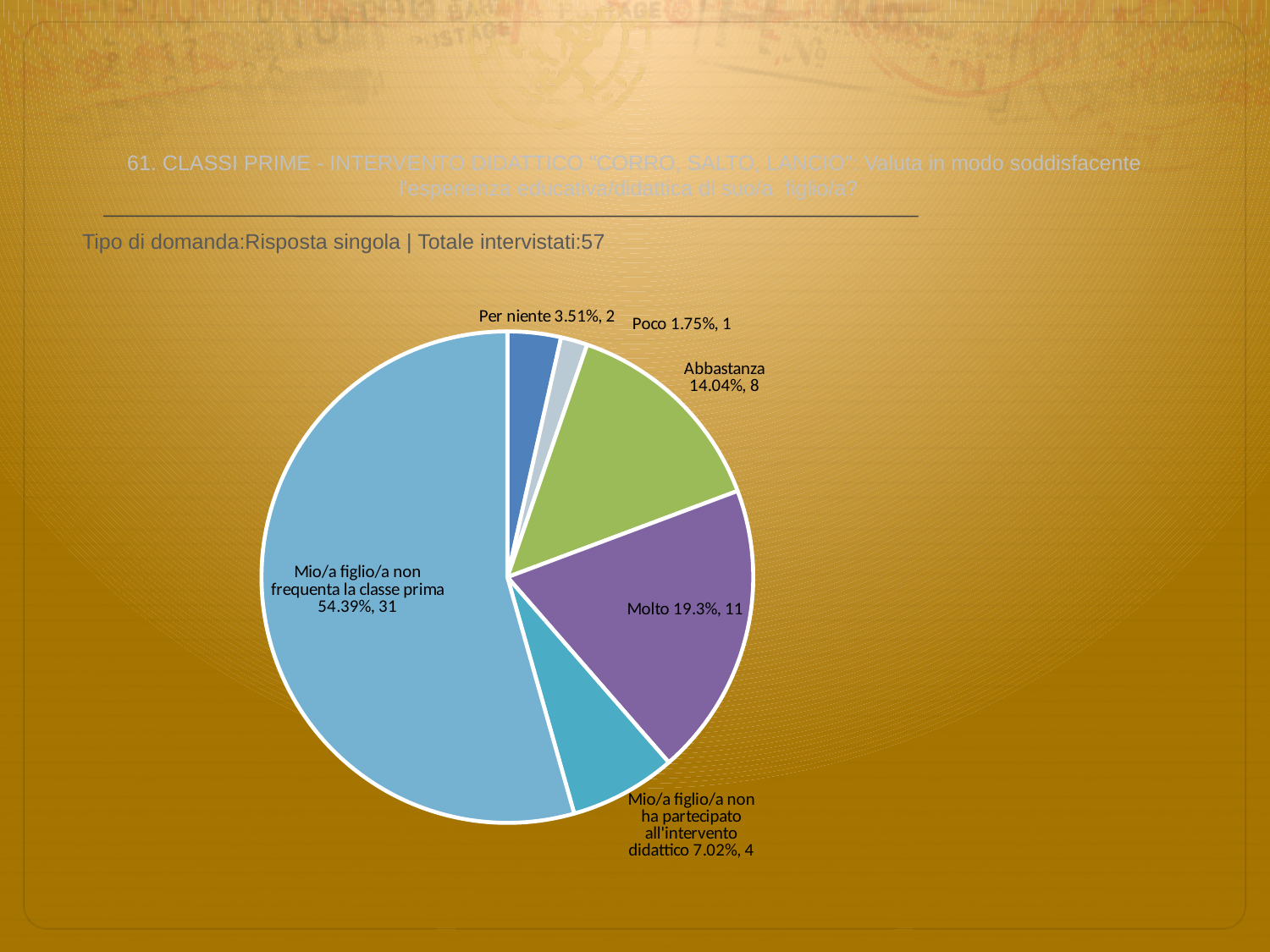
What share of the pie does "Mio/a figlio/a non frequenta la classe prima" represent? 54.39% What is the difference in respondent count between "Molto" and "Abbastanza"? 3 Which category has the smallest slice of the pie? Poco What kind of chart is shown on the slide? pie chart How many respondents are in the "Per niente" slice? 2 How many slices does the pie chart have? 6 What percentage is shown for "Poco"? 1.75% What is the total number of respondents (Totale intervistati) stated on the slide? 57 Which slice is larger, "Abbastanza" or "Mio/a figlio/a non ha partecipato all'intervento didattico"? Abbastanza Which category has the largest slice of the pie? Mio/a figlio/a non frequenta la classe prima How many respondents chose "Abbastanza"? 8 What percentage is shown for the "Molto" slice? 19.3%